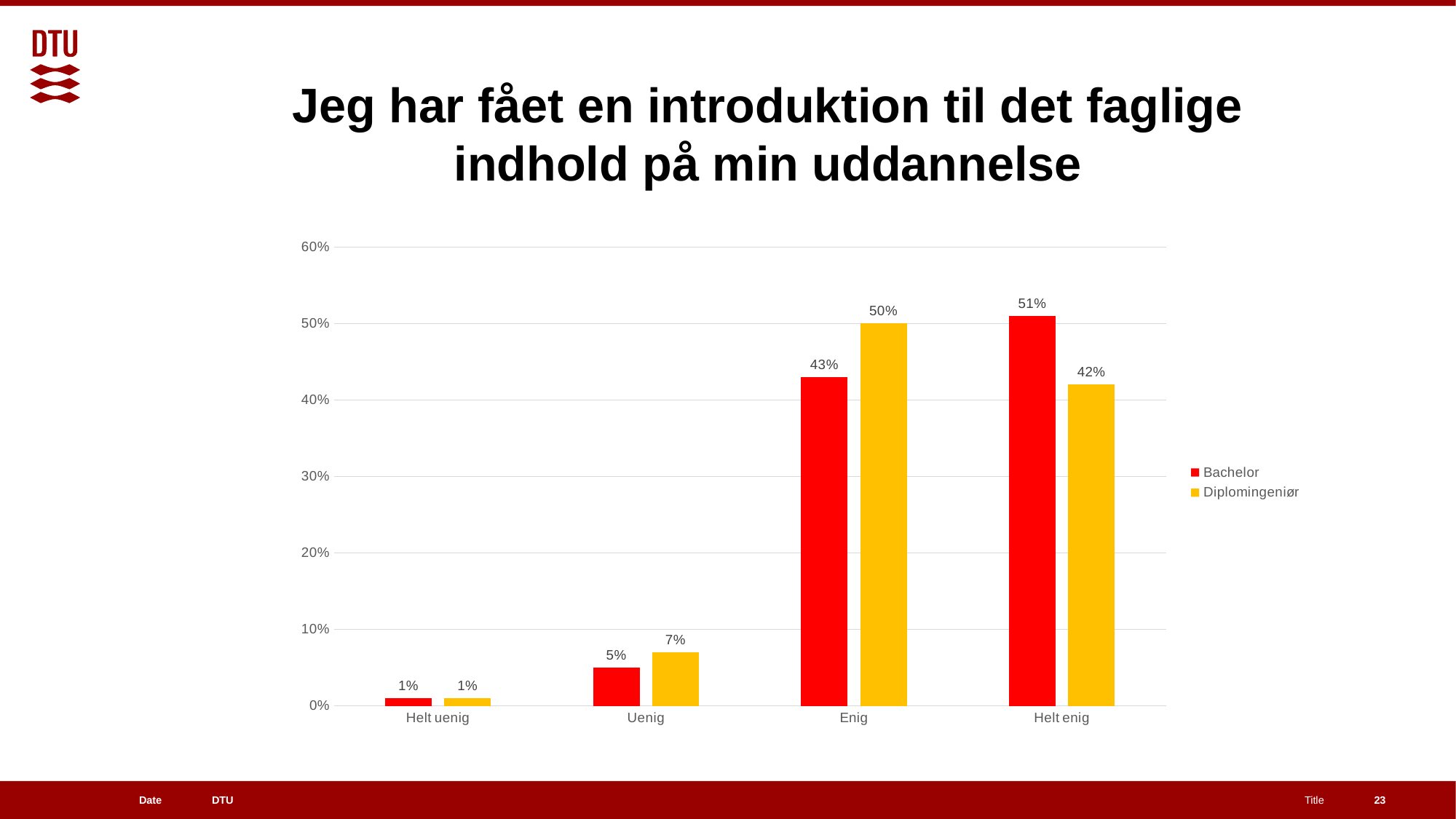
How many categories are shown on the x axis? 4 What is the difference between the Diplomingeniør and Bachelor values for Enig? 7% Which category has the highest Diplomingeniør value? Enig What is the Bachelor value for Enig? 43% Which category has the highest Bachelor value? Helt enig What is the difference between the Bachelor and Diplomingeniør values for Helt enig? 9% What is the Diplomingeniør value for Helt enig? 42% What kind of chart is shown on the slide? Bar chart Which colour represents the Bachelor series? Red How many series does the legend list? 2 For Uenig, which series has the larger value, Bachelor or Diplomingeniør? Diplomingeniør What is the Diplomingeniør value for Uenig? 7%